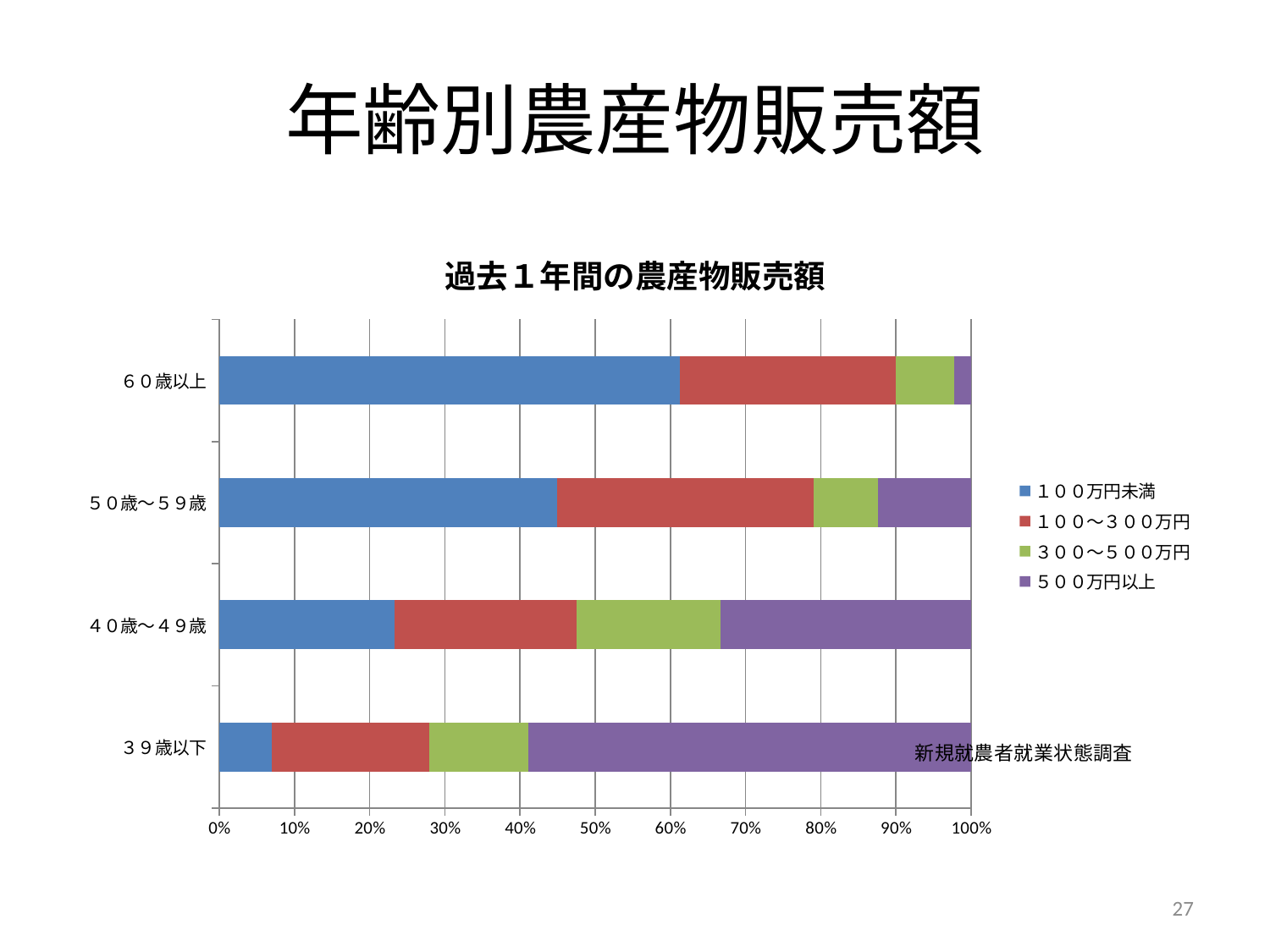
Going from ３９歳以下 up to ６０歳以上, does the share of １００万円未満 rise or fall? rise Which age category has the largest share of ５００万円以上? ３９歳以下 Which legend entry is shown in purple? ５００万円以上 How many age categories are plotted on the chart? 4 How many series does the legend list? 4 Which age category has the smallest share of １００万円未満? ３９歳以下 Which is larger: the share of ５００万円以上 for ４０歳〜４９歳 or for ５０歳〜５９歳? ４０歳〜４９歳 Is the share of １００万円未満 for ６０歳以上 greater or less than 50%? greater What is the title of the chart? 過去１年間の農産物販売額 Is the share of １００万円未満 for ３９歳以下 greater or less than 10%? less Which age category has the largest share of １００万円未満? ６０歳以上 What kind of chart is shown on the slide? Stacked bar chart